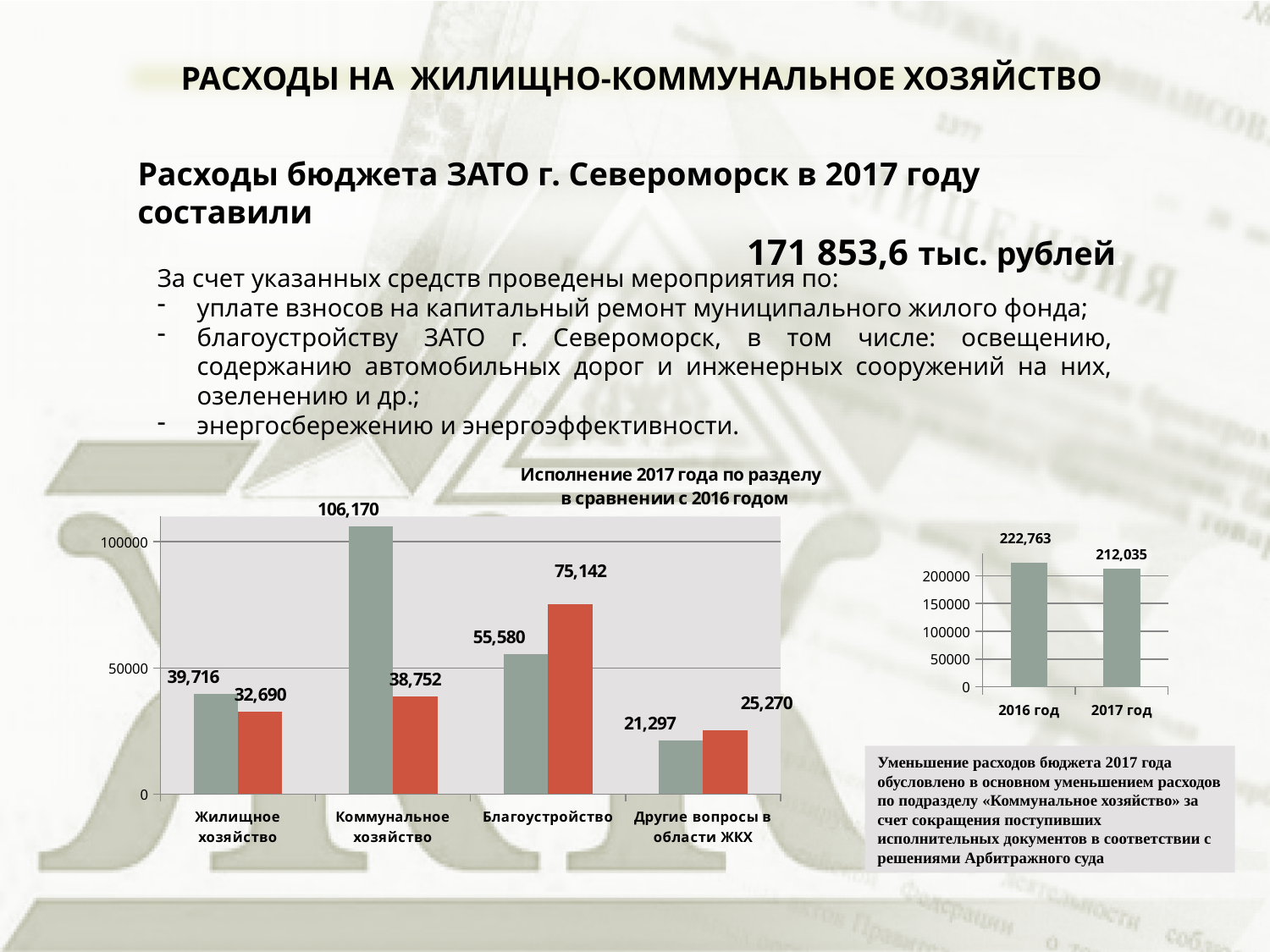
On the chart titled 'Исполнение 2017 года по разделу в сравнении с 2016 годом', what is the difference between the grey and red bars for 'Коммунальное хозяйство'? 67,418 What kind of chart is the chart titled 'Исполнение 2017 года по разделу в сравнении с 2016 годом'? bar chart On the small chart on the right of the slide, do the values rise or fall from 2016 год to 2017 год? fall On the chart titled 'Исполнение 2017 года по разделу в сравнении с 2016 годом', which category has the highest grey bar? Коммунальное хозяйство On the chart titled 'Исполнение 2017 года по разделу в сравнении с 2016 годом', what is the value of the grey bar for 'Коммунальное хозяйство'? 106,170 On the chart titled 'Исполнение 2017 года по разделу в сравнении с 2016 годом', how many categories are shown on the x axis? 4 On the chart titled 'Исполнение 2017 года по разделу в сравнении с 2016 годом', which category has the lowest red bar? Другие вопросы в области ЖКХ On the small chart on the right of the slide, what is the value for '2017 год'? 212,035 On the chart titled 'Исполнение 2017 года по разделу в сравнении с 2016 годом', what is the value of the red bar for 'Благоустройство'? 75,142 On the chart titled 'Исполнение 2017 года по разделу в сравнении с 2016 годом', what is the value of the red bar for 'Жилищное хозяйство'? 32,690 On the small chart on the right of the slide, what is the value for '2016 год'? 222,763 On the chart titled 'Исполнение 2017 года по разделу в сравнении с 2016 годом', for 'Благоустройство', which bar is larger, the grey or the red? red